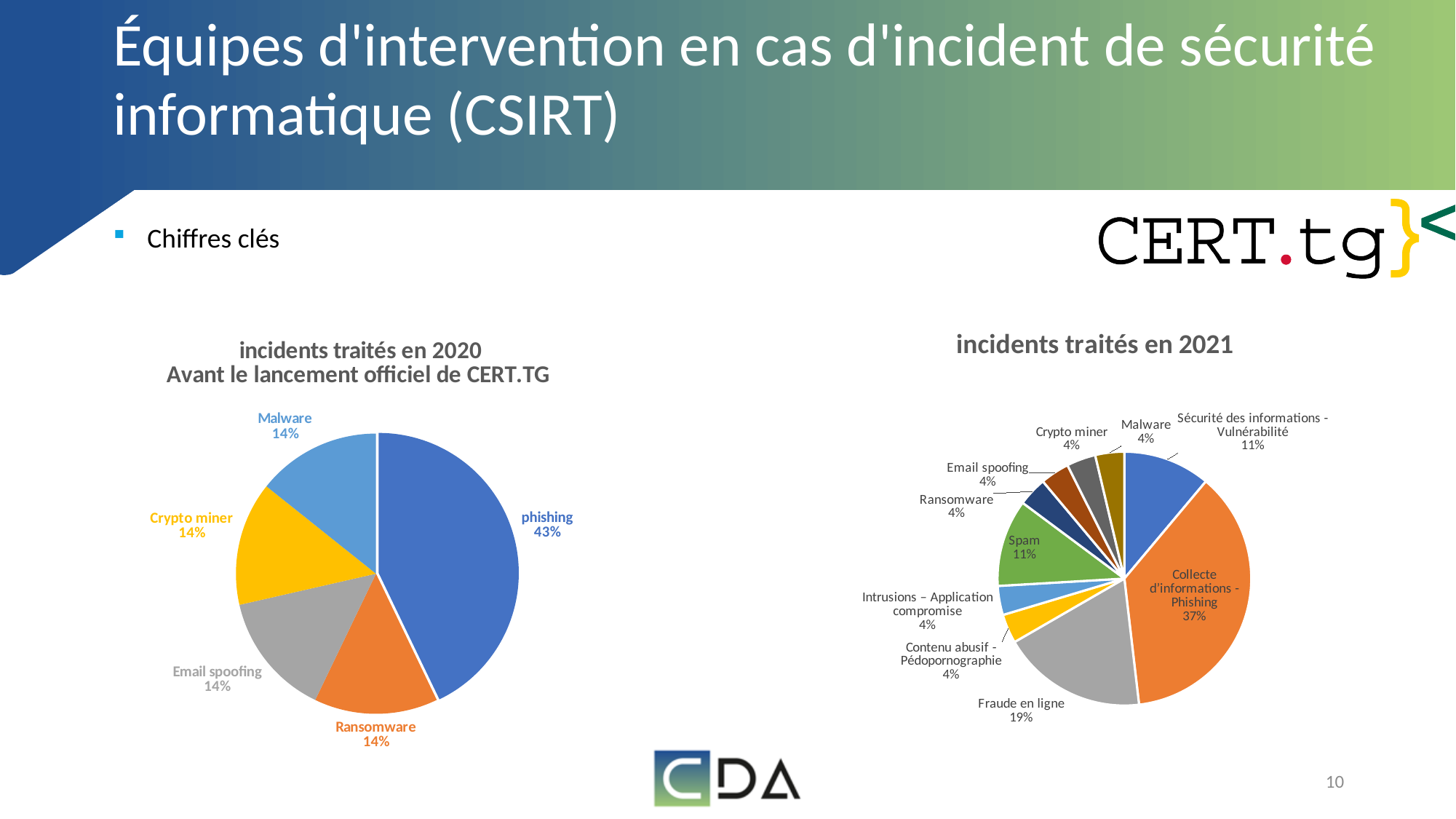
In the 'incidents traités en 2021' chart, what share of incidents is 'Fraude en ligne'? 19% In the 'incidents traités en 2020' chart, what is the difference between the phishing share and the Ransomware share? 29% What type of chart is used for 'incidents traités en 2021'? Pie chart In the 'incidents traités en 2021' chart, what is the difference between the 'Collecte d'informations - Phishing' share and the 'Fraude en ligne' share? 18% How many categories are shown in the 'incidents traités en 2021' pie chart? 10 In the 'incidents traités en 2021' chart, what share of incidents is 'Collecte d'informations - Phishing'? 37% How many categories are shown in the 'incidents traités en 2020' pie chart? 5 In the 'incidents traités en 2021' chart, which category has the largest share? Collecte d'informations - Phishing In the 'incidents traités en 2020' chart, what share of incidents is phishing? 43% In the 'incidents traités en 2021' chart, which is larger: Fraude en ligne or Spam? Fraude en ligne In the 'incidents traités en 2021' chart, what share of incidents is Spam? 11% In the 'incidents traités en 2020' chart, which category has the largest share? phishing